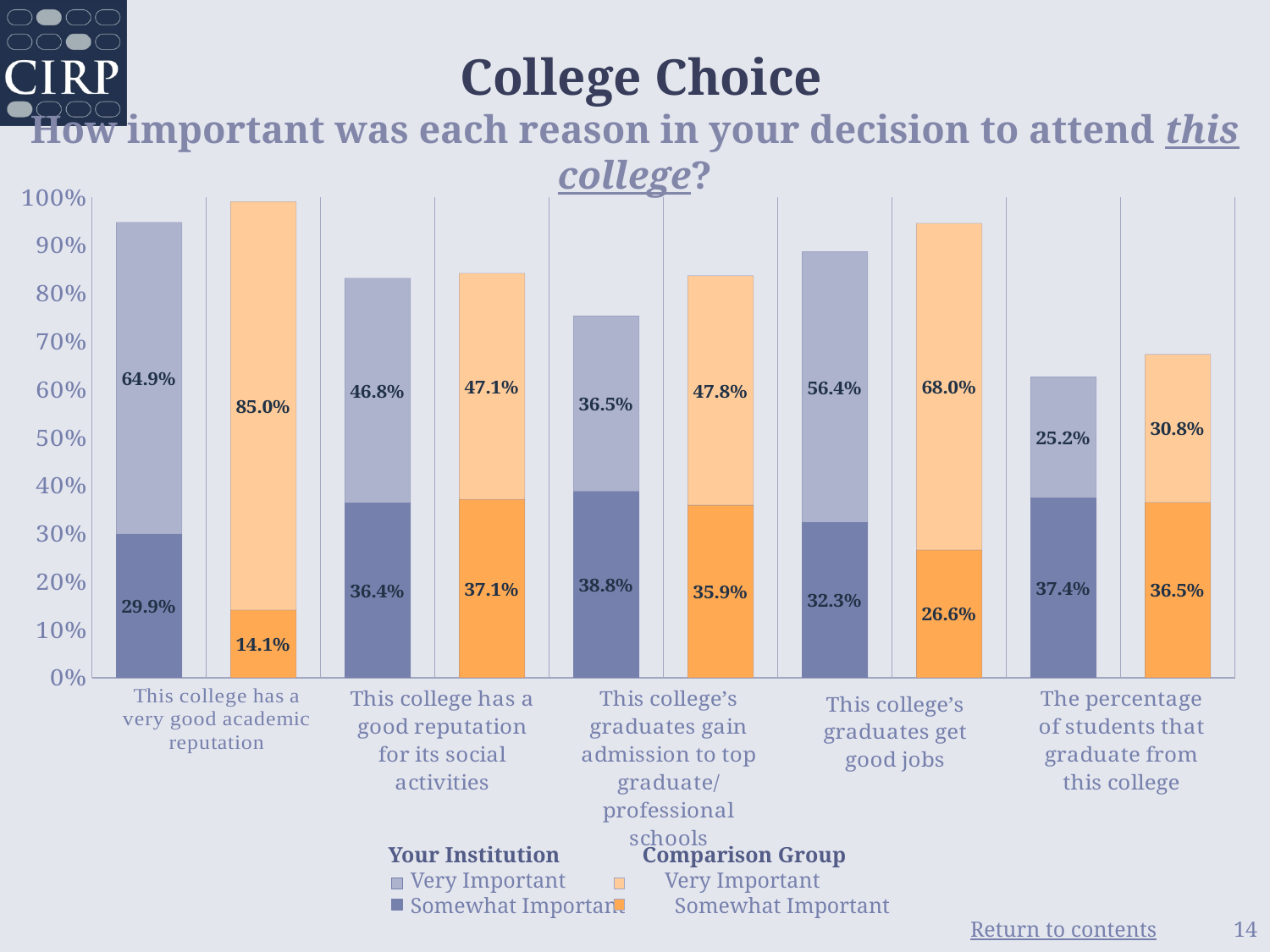
Among Your Institution's Very Important values, which reason has the lowest value? The percentage of students that graduate from this college What is the difference between the Comparison Group's and Your Institution's Very Important values for "This college has a very good academic reputation"? 20.1% What is the combined total (Very Important plus Somewhat Important) for Your Institution on "This college's graduates get good jobs"? 88.7% What kind of chart is shown on the slide? Stacked bar chart What is the combined total (Very Important plus Somewhat Important) for the Comparison Group on "The percentage of students that graduate from this college"? 67.3% What percentage of Your Institution students rated "This college has a very good academic reputation" as Very Important? 64.9% What percentage of the Comparison Group rated "This college's graduates get good jobs" as Somewhat Important? 26.6% What percentage of Your Institution students rated "The percentage of students that graduate from this college" as Very Important? 25.2% For "This college's graduates gain admission to top graduate/professional schools", which is larger: Your Institution's Very Important value or the Comparison Group's Very Important value? Comparison Group Among the Comparison Group's Very Important values, which reason has the highest value? This college has a very good academic reputation How many entries does the legend list? 4 How many reasons (categories) are shown on the x axis of the chart? 5